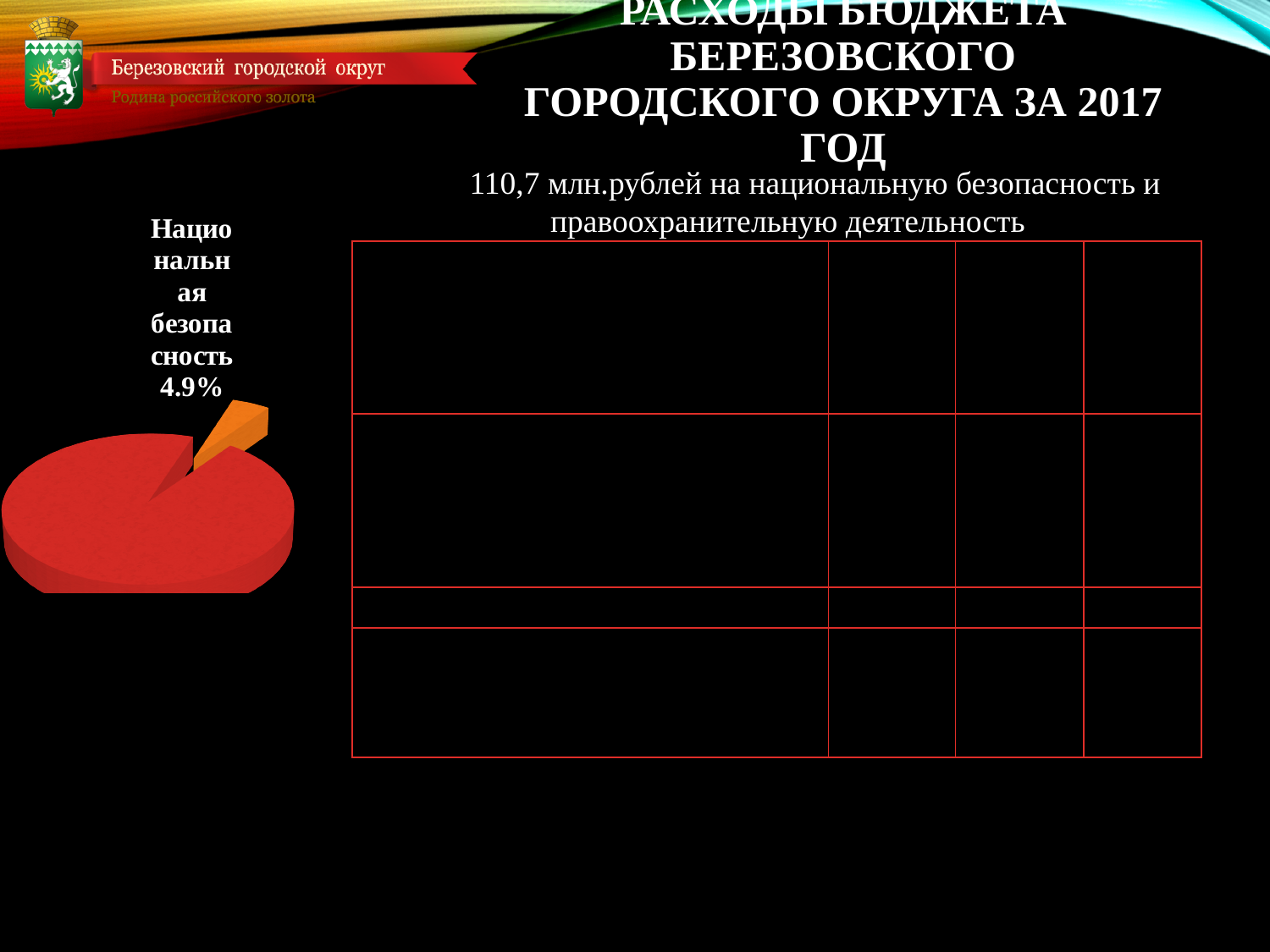
How many slices does the pie chart have? 2 What kind of chart is shown on the left of the slide? pie chart Which slice of the pie chart is the smallest? Национальная безопасность Which slice of the pie chart is pulled out (exploded) from the rest of the pie? Национальная безопасность What share of the pie does the slice labelled "Национальная безопасность" represent? 4.9% Which slice of the pie chart is larger, the orange slice or the red slice? the red slice What colour is the slice labelled "Национальная безопасность" in the pie chart? orange